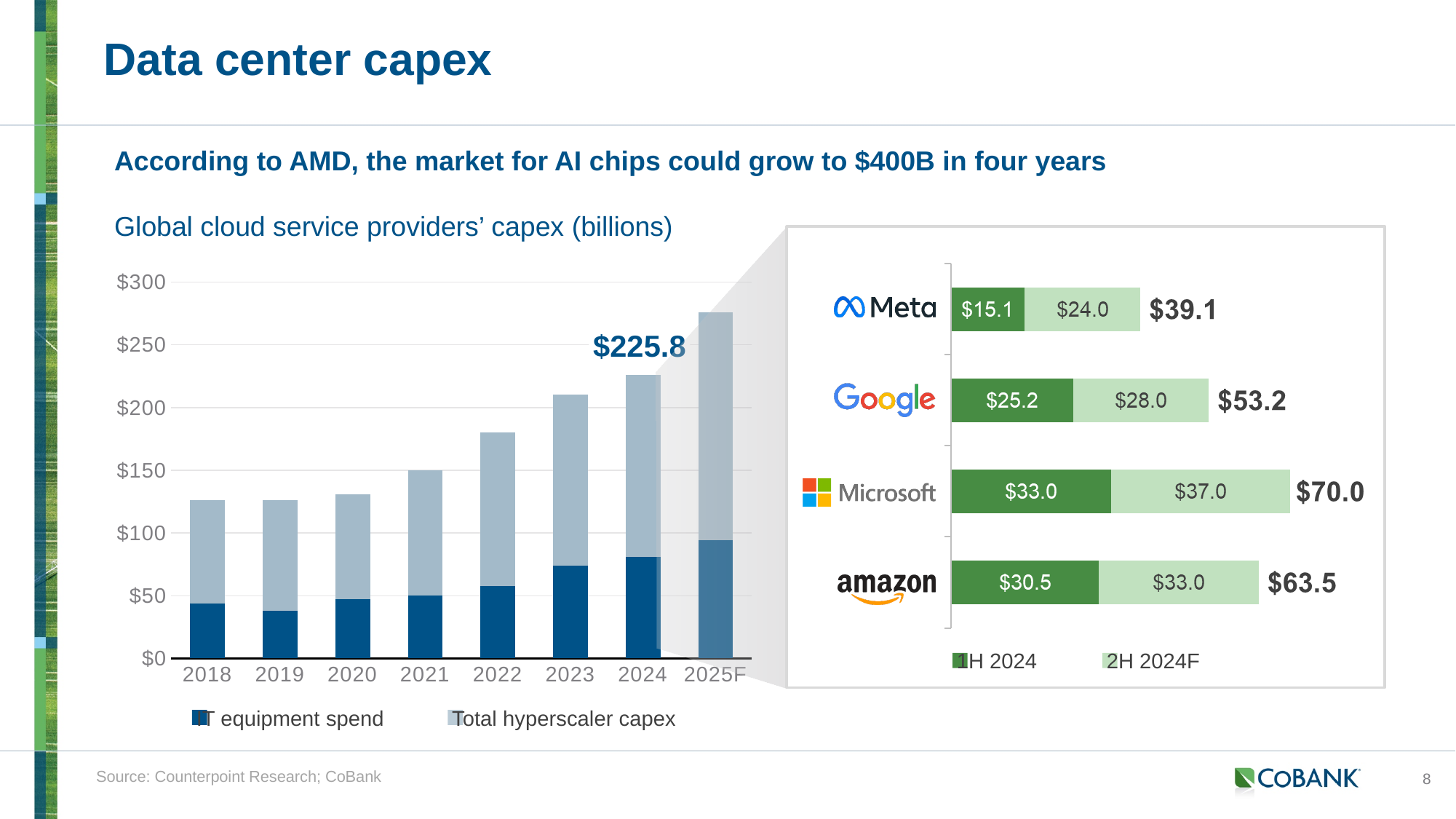
In the 'Global cloud service providers' capex (billions)' chart, how many years are shown on the x axis? 8 In the inset chart on the right, what is the total for Amazon? $63.5 In the 'Global cloud service providers' capex (billions)' chart, do the total bars generally rise or fall from 2018 to 2025F? rise In the 'Global cloud service providers' capex (billions)' chart, how many series does the legend list? 2 In the 'Global cloud service providers' capex (billions)' chart, what is the labeled value for 2024? $225.8 In the 'Global cloud service providers' capex (billions)' chart, is the total bar for 2025F greater or less than $250? greater In the 'Global cloud service providers' capex (billions)' chart, is the total bar for 2018 greater or less than $150? less In the inset chart on the right, which company has the highest total? Microsoft In the inset chart on the right, what is the 2H 2024F value for Google? $28.0 In the inset chart on the right, what is the 1H 2024 value for Meta? $15.1 In the inset chart on the right, which company has the lowest total? Meta In the inset chart on the right, what is the difference between Microsoft's 2H 2024F value and its 1H 2024 value? $4.0